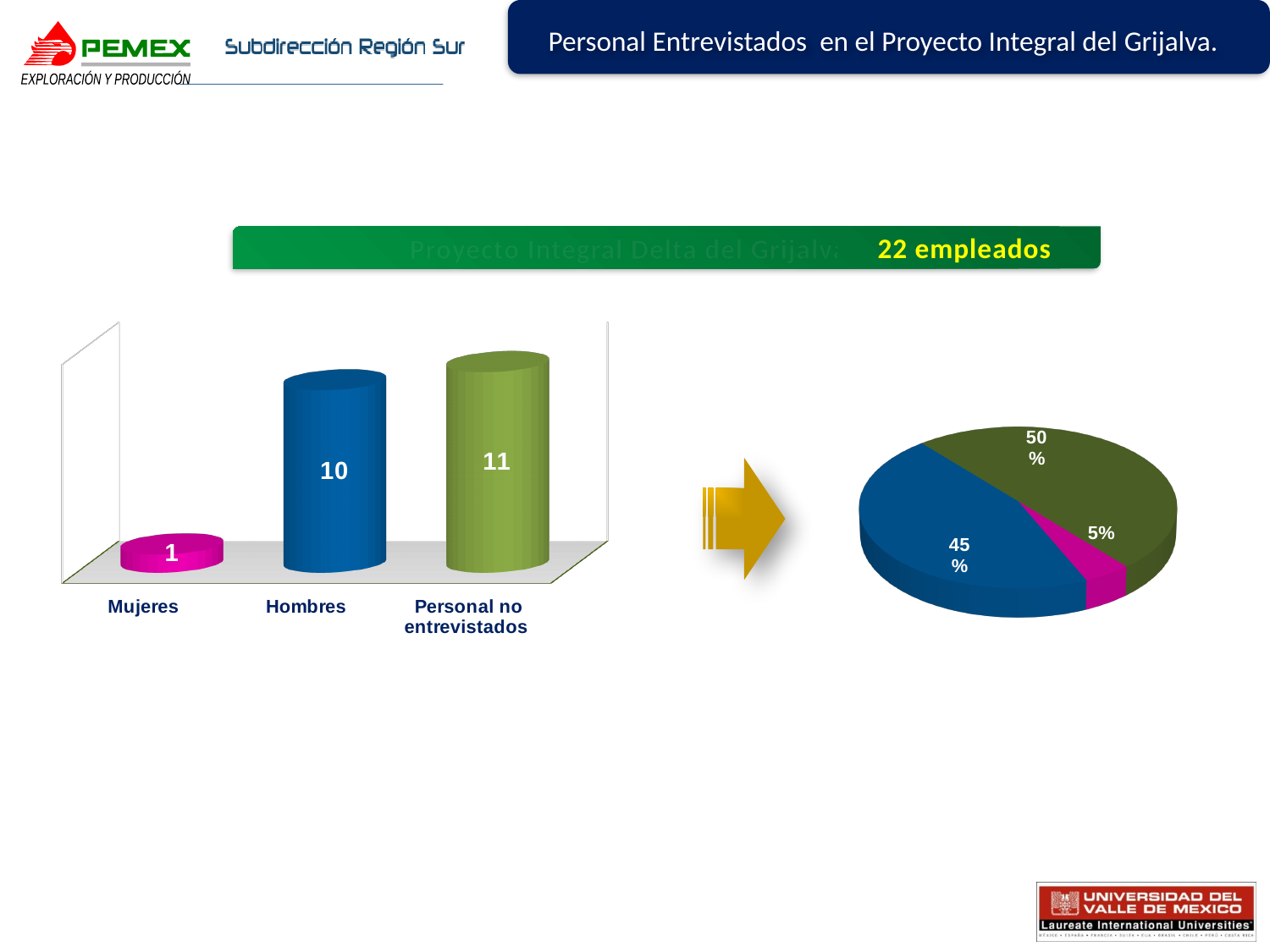
In the bar chart on the left, which category has the lowest value? Mujeres In the bar chart on the left, what is the value for Mujeres? 1 In the pie chart on the right, what share does the largest slice have? 50% What kind of chart is the chart on the left of the slide? Bar chart In the bar chart on the left, which category has the highest value? Personal no entrevistados In the bar chart on the left, what is the value for Personal no entrevistados? 11 How many categories does the bar chart on the left show? 3 In the pie chart on the right, what share does the magenta slice have? 5% In the bar chart on the left, what is the difference between the values for Hombres and Mujeres? 9 In the bar chart on the left, which is larger, the value for Hombres or the value for Personal no entrevistados? Personal no entrevistados In the bar chart on the left, what is the value for Hombres? 10 What kind of chart is the chart on the right of the slide? Pie chart